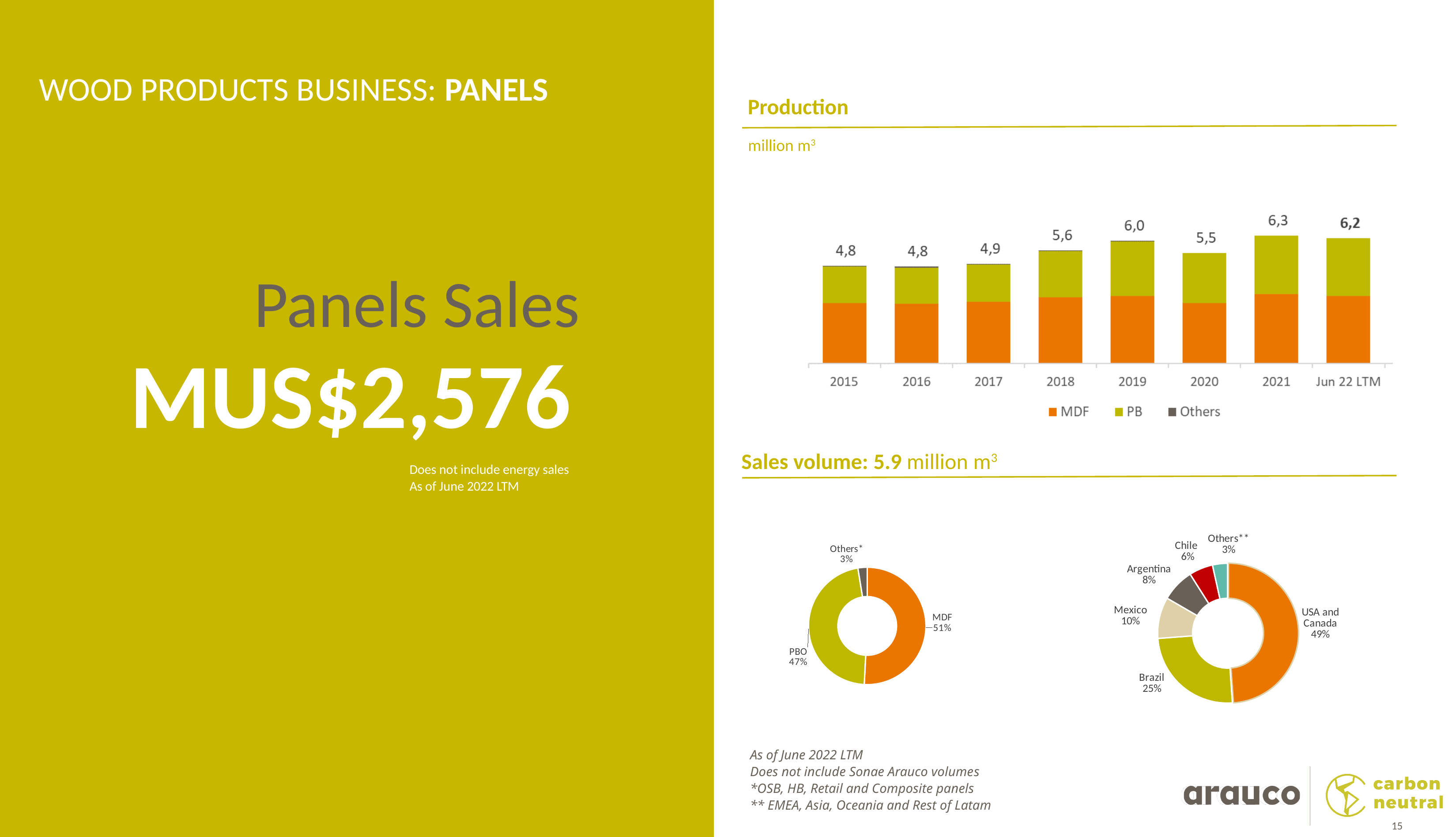
In the Production chart, which year has the highest total production? 2021 In the Production chart, how many series does the legend list? 3 In the right donut chart under Sales volume, which region has the largest share? USA and Canada What kind of chart is the Production chart? stacked bar chart In the Production chart, is the total for 2018 larger or smaller than the total for 2020? larger In the left donut chart under Sales volume, what share does PBO have? 47% In the Production chart, which series is shown in orange? MDF In the left donut chart under Sales volume, what share does MDF have? 51% In the right donut chart under Sales volume, what is the difference between the shares of Brazil and Mexico? 15% In the Production chart, what is the total production value for 2019? 6,0 In the Production chart, what is the difference between the total for 2021 and the total for 2015? 1,5 In the Production chart, how many periods are shown on the x axis? 8